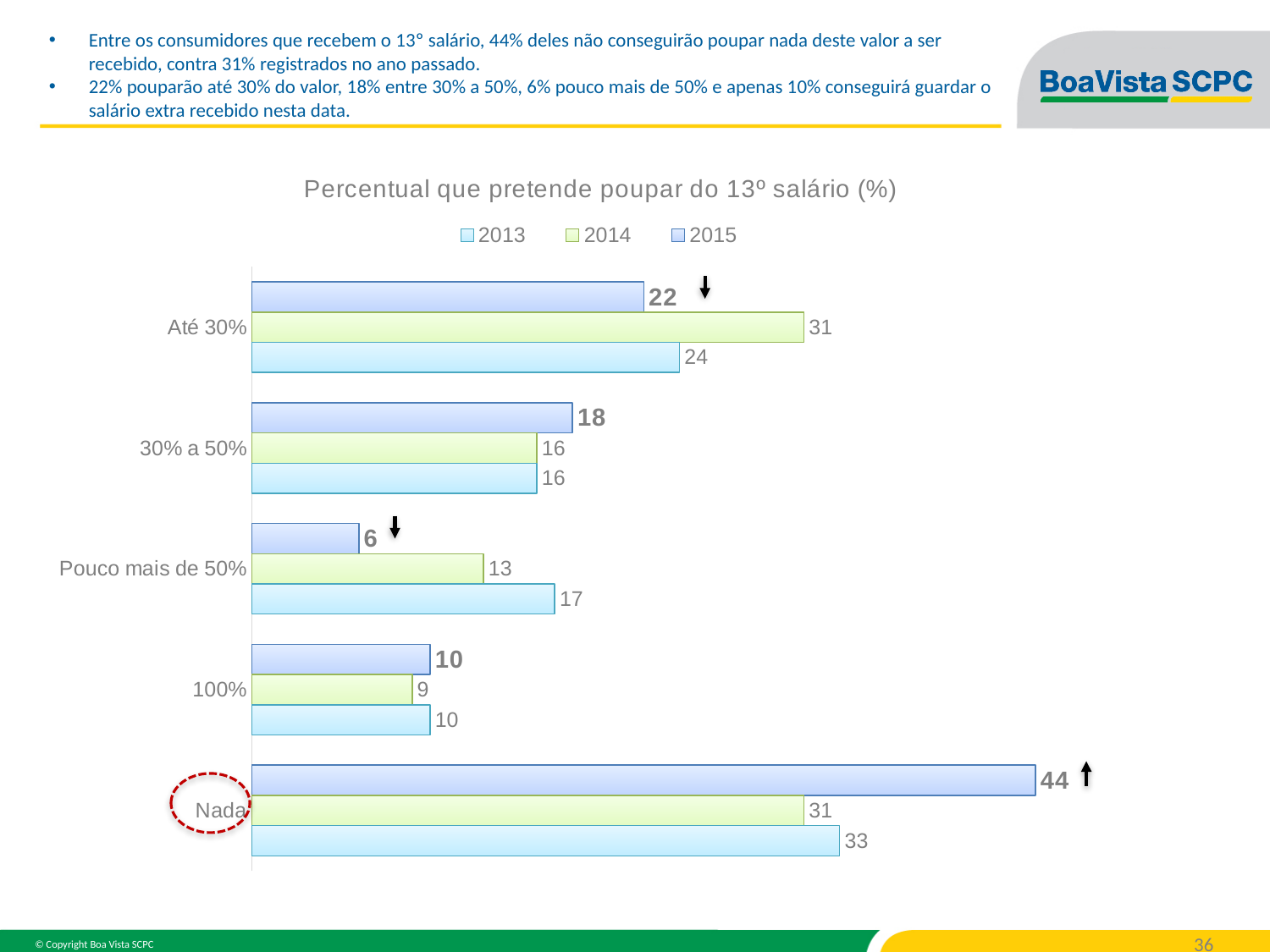
How many series does the legend list? 3 What is the value for 2015 in the 'Nada' category? 44 What is the value for 2014 in the 'Até 30%' category? 31 What is the difference between the 2014 and 2013 values in the '100%' category? 1 In the 'Pouco mais de 50%' category, which year has the larger value, 2013 or 2015? 2013 Which category has the lowest value for the 2015 series? Pouco mais de 50% What is the difference between the 2015 and 2014 values in the 'Nada' category? 13 What is the value for 2013 in the 'Pouco mais de 50%' category? 17 What is the title of the chart? Percentual que pretende poupar do 13º salário (%) Which category has the highest value for the 2015 series? Nada How many categories are shown on the chart? 5 What kind of chart is shown on the slide? Bar chart